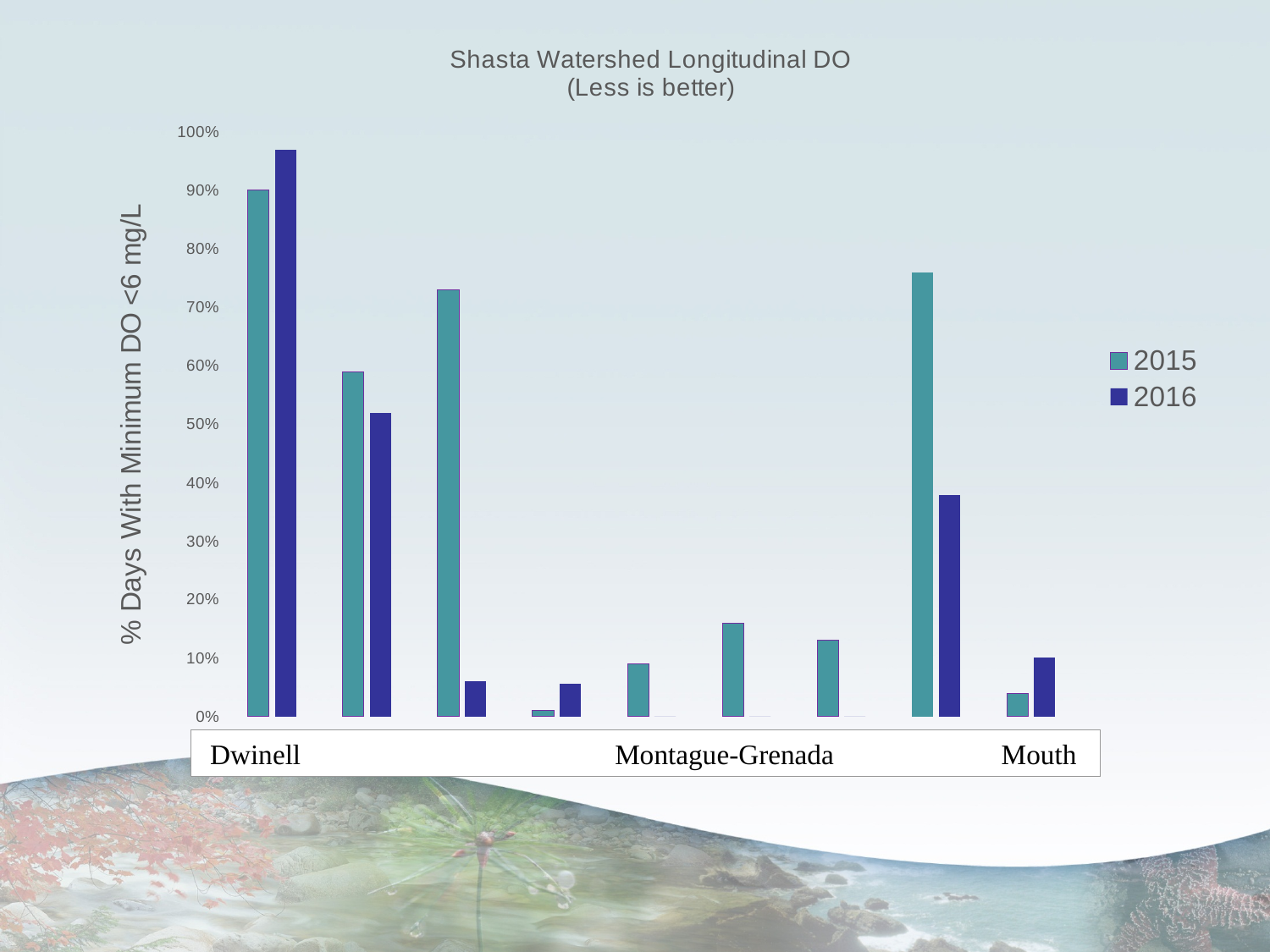
In the rightmost group of bars (Mouth), is the 2016 value greater or less than 20%? less What is the label on the vertical axis? % Days With Minimum DO <6 mg/L In the leftmost group of bars, is the 2016 value greater or less than 90%? greater Which series contains the single tallest bar on the chart? 2016 In the leftmost group of bars, is the 2015 value greater or less than 80%? greater What kind of chart is shown on the slide? bar chart In the leftmost group of bars (Dwinell), which year has the higher value, 2015 or 2016? 2016 What is the title of the chart? Shasta Watershed Longitudinal DO (Less is better) How many groups of bars (sites) are plotted along the x axis? 9 How many series does the legend list? 2 In the rightmost group of bars (Mouth), which year has the higher value, 2015 or 2016? 2016